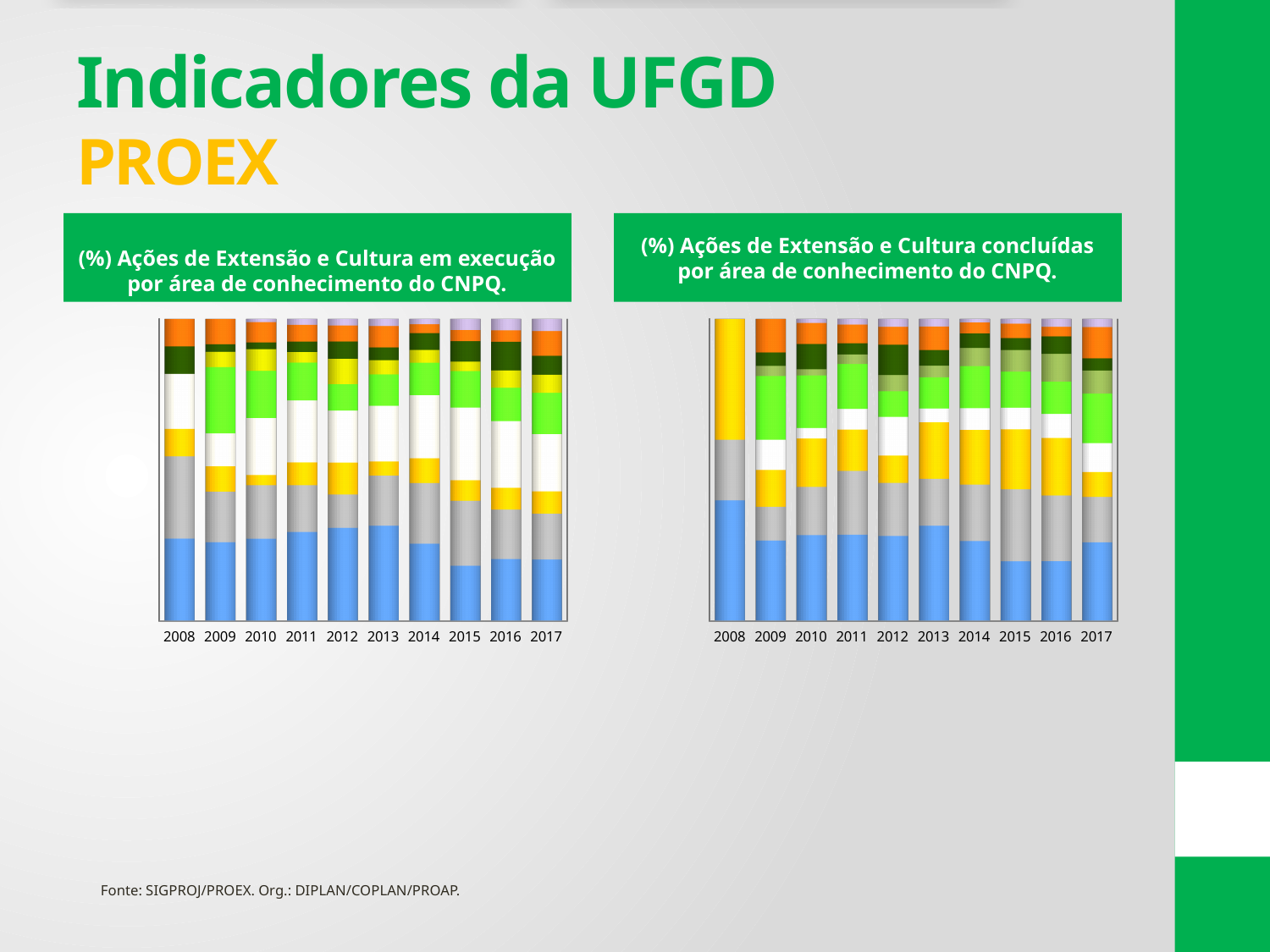
What kind of chart is the left chart, '(%) Ações de Extensão e Cultura em execução por área de conhecimento do CNPQ'? Stacked bar chart How many bars does the right chart, '(%) Ações de Extensão e Cultura concluídas por área de conhecimento do CNPQ', have? 10 What is the last year shown on the x axis of the right chart? 2017 How many years are shown on the x axis of the left chart, '(%) Ações de Extensão e Cultura em execução por área de conhecimento do CNPQ'? 10 In the right chart, '(%) Ações de Extensão e Cultura concluídas', which year has the largest blue (bottom) segment? 2008 What kind of chart is the right chart, '(%) Ações de Extensão e Cultura concluídas por área de conhecimento do CNPQ'? Stacked bar chart In the right chart, '(%) Ações de Extensão e Cultura concluídas', is the yellow segment larger in 2008 or in 2017? 2008 What is the first year shown on the x axis of the left chart? 2008 In the left chart, '(%) Ações de Extensão e Cultura em execução', which year has the smallest blue (bottom) segment? 2015 In the left chart, '(%) Ações de Extensão e Cultura em execução', is the blue (bottom) segment larger in 2013 or in 2015? 2013 In the right chart, '(%) Ações de Extensão e Cultura concluídas', is the blue (bottom) segment larger in 2008 or in 2015? 2008